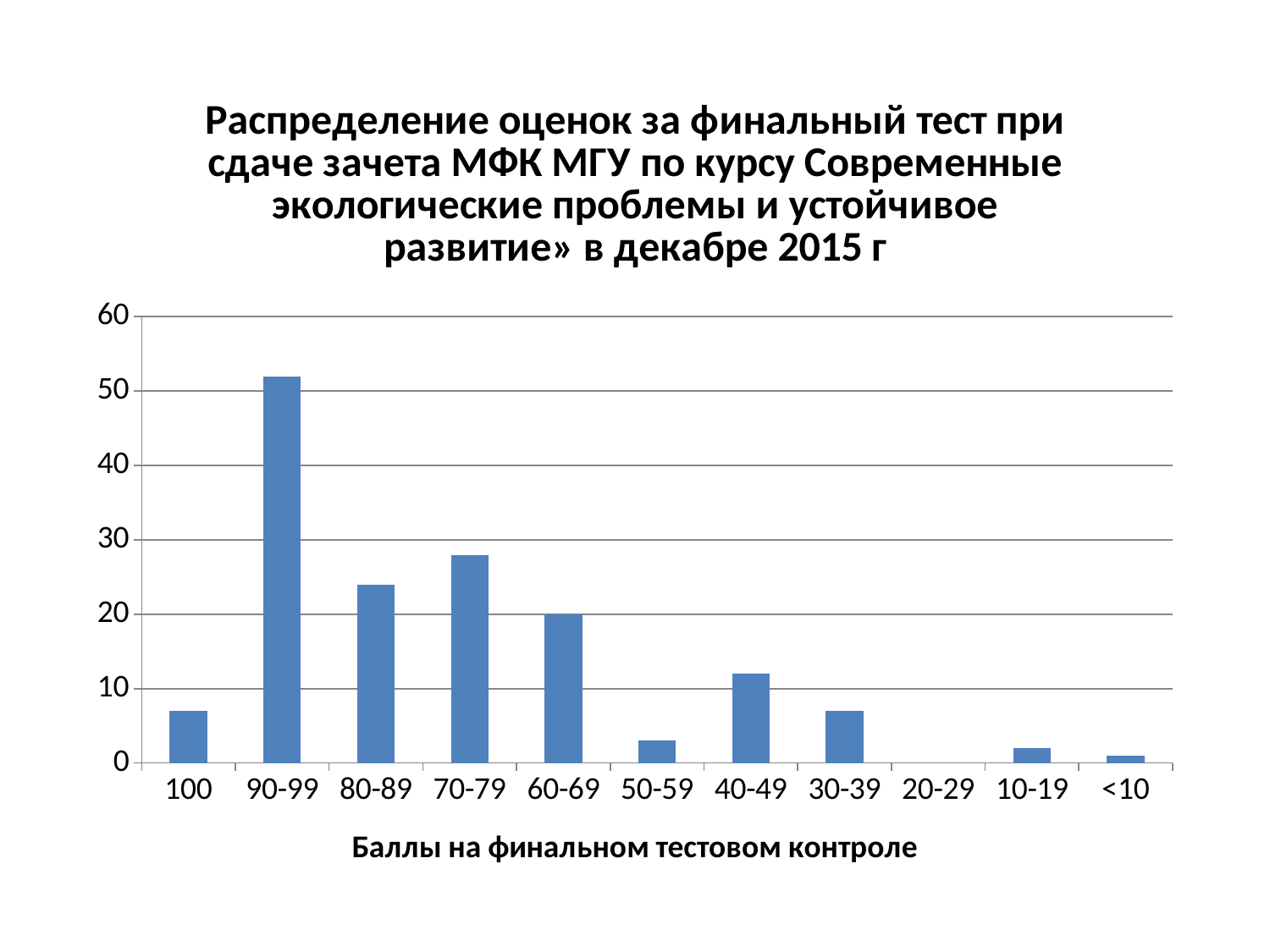
Is the value for 100 greater or less than 10? less Is the value for 40-49 greater or less than 10? greater Is the value for 50-59 greater or less than 10? less Which score range has the highest number of students? 90-99 What is the x-axis title of the chart? Баллы на финальном тестовом контроле Which has a larger value, 70-79 or 80-89? 70-79 What kind of chart is shown on the slide? bar chart Which has a larger value, 40-49 or 30-39? 40-49 Which score range has the lowest value (no bar at all)? 20-29 How many score categories are shown on the x axis? 11